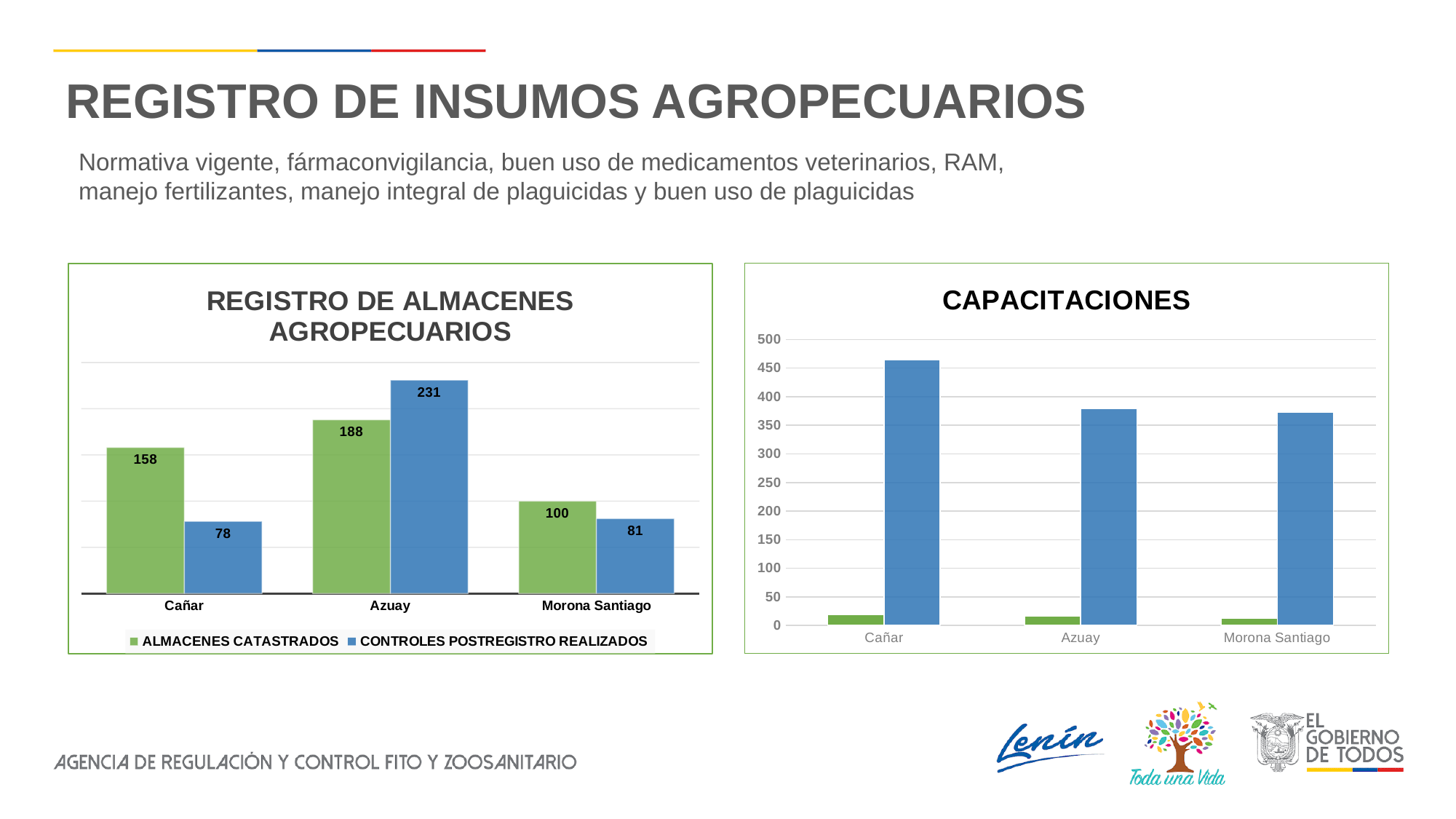
In the REGISTRO DE ALMACENES AGROPECUARIOS chart, what is the difference between ALMACENES CATASTRADOS and CONTROLES POSTREGISTRO REALIZADOS for Cañar? 80 In the REGISTRO DE ALMACENES AGROPECUARIOS chart, what is the value of ALMACENES CATASTRADOS for Cañar? 158 What type of chart is the CAPACITACIONES chart? Bar chart In the REGISTRO DE ALMACENES AGROPECUARIOS chart, which province has the highest value of ALMACENES CATASTRADOS? Azuay In the CAPACITACIONES chart, which province has the highest blue bar? Cañar How many series does the legend of the REGISTRO DE ALMACENES AGROPECUARIOS chart list? 2 In the REGISTRO DE ALMACENES AGROPECUARIOS chart, which is larger for Morona Santiago: ALMACENES CATASTRADOS or CONTROLES POSTREGISTRO REALIZADOS? ALMACENES CATASTRADOS In the REGISTRO DE ALMACENES AGROPECUARIOS chart, what is the value of CONTROLES POSTREGISTRO REALIZADOS for Azuay? 231 In the REGISTRO DE ALMACENES AGROPECUARIOS chart, which province has the lowest value of CONTROLES POSTREGISTRO REALIZADOS? Cañar How many provinces are shown on the x axis of the CAPACITACIONES chart? 3 In the CAPACITACIONES chart, is the blue bar for Cañar greater or less than 450? greater In the CAPACITACIONES chart, is the blue bar for Azuay greater or less than 350? greater